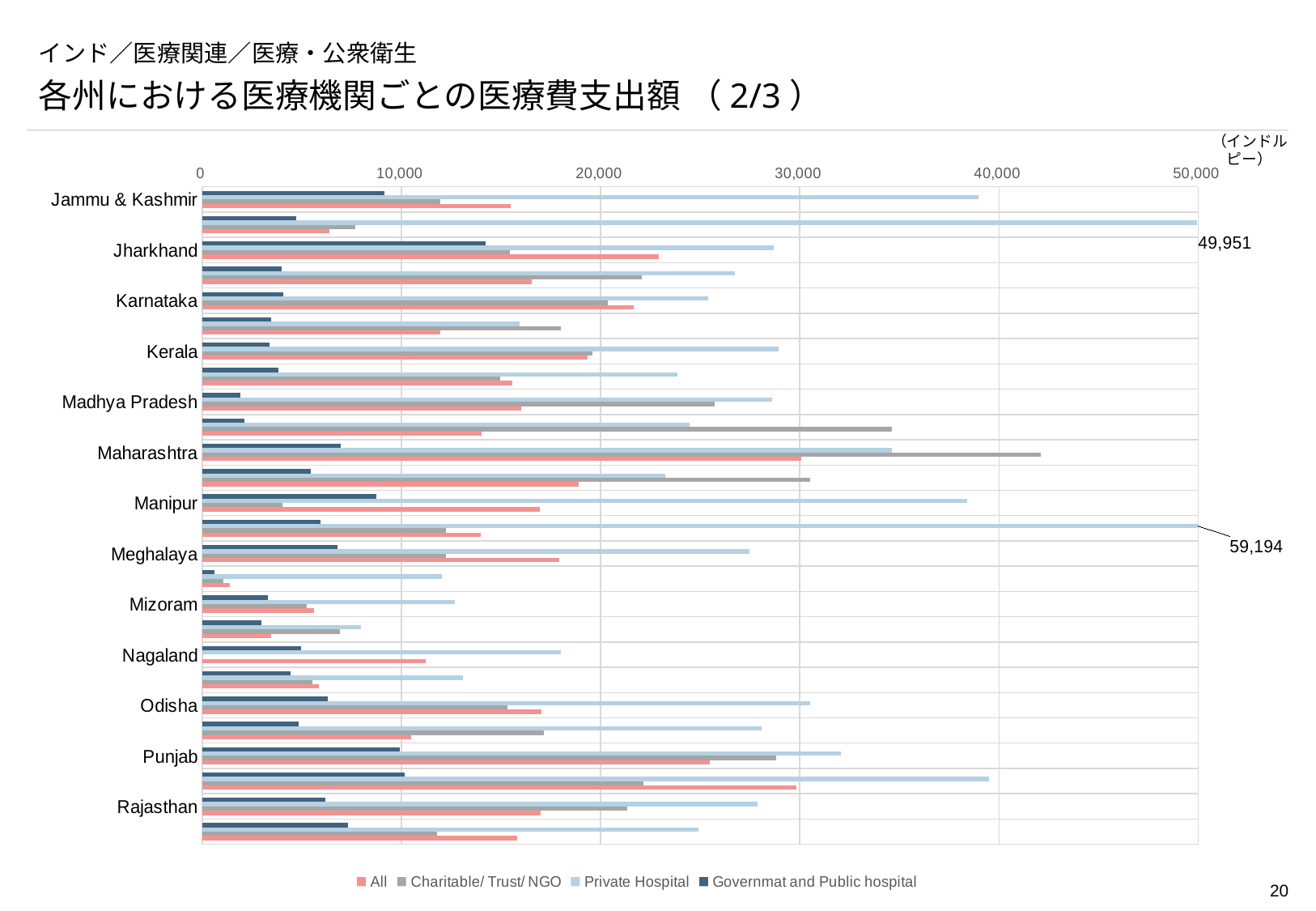
Is the Private Hospital value for Jammu & Kashmir greater or less than 30,000? greater For Jammu & Kashmir, which is larger: the Private Hospital value or the Governmat and Public hospital value? Private Hospital What kind of chart is shown on the slide? Bar chart Is the All value for Mizoram greater or less than 10,000? less Is the Charitable/ Trust/ NGO value for Maharashtra greater or less than 30,000? greater For Jammu & Kashmir, which series has the highest value? Private Hospital What unit is indicated at the top right of the chart? インドルピー What value does the data label placed just below the 50,000 axis line near the top of the chart show? 49,951 For Maharashtra, which series has the highest value? Charitable/ Trust/ NGO How many series does the legend list? 4 What is the largest value printed as a data label on the chart? 59,194